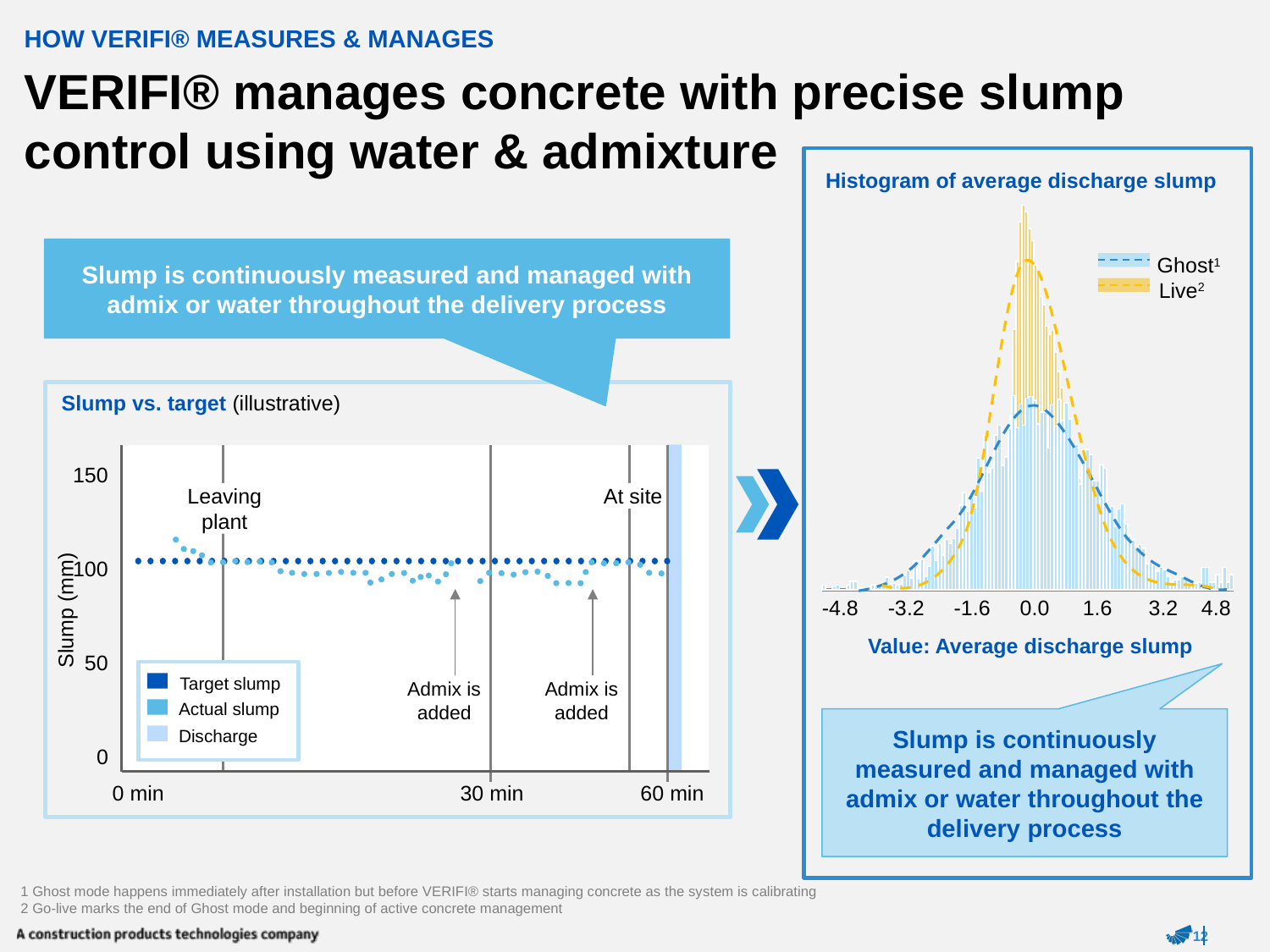
In the 'Histogram of average discharge slump' chart, how many tick labels are shown on the x axis? 7 In the 'Histogram of average discharge slump' chart, which series has the higher peak, Ghost or Live? Live In the 'Histogram of average discharge slump' chart, how many series does the legend list? 2 In the 'Histogram of average discharge slump' chart, what is the label on the x axis? Value: Average discharge slump What kind of chart is the 'Histogram of average discharge slump'? histogram (bar chart) In the 'Slump vs. target' chart, what are the three legend entries? Target slump, Actual slump, Discharge In the 'Slump vs. target' chart, does the target slump line rise, fall, or stay flat from 0 min to 60 min? stays flat In the 'Slump vs. target' chart, how many series does the legend list? 3 In the 'Slump vs. target' chart, what is the lowest x-axis tick label? 0 min In the 'Slump vs. target' chart, what is the label on the y axis? Slump (mm) In the 'Slump vs. target' chart, is the target slump value greater or less than 50? greater In the 'Slump vs. target' chart, is the actual slump at 30 min greater or less than 150? less